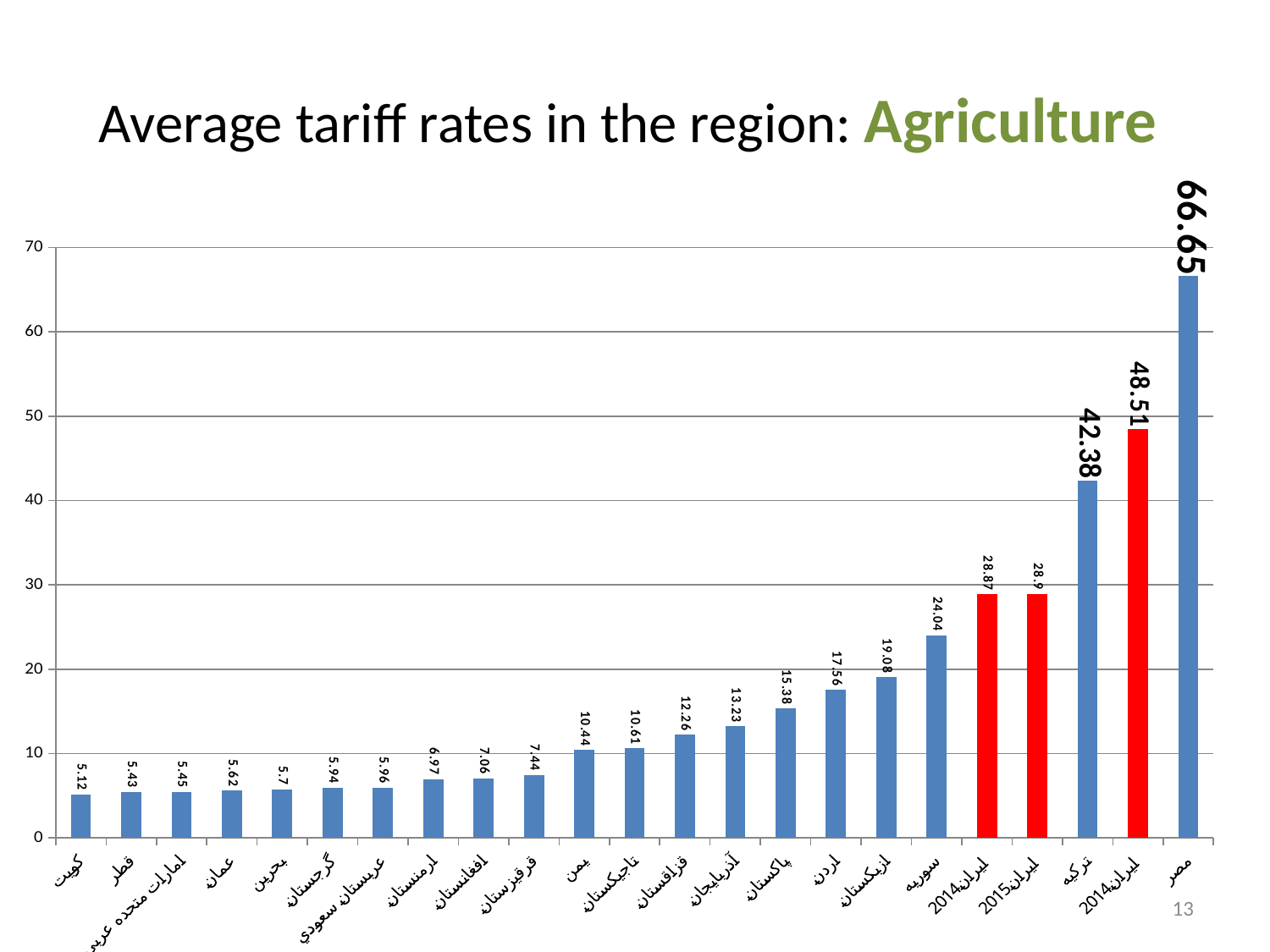
How many bars are shown in the chart? 23 What is the value for سوریه? 24.04 What is the value for ترکیه? 42.38 Which category has the highest value? مصر What is the value for پاکستان? 15.38 Which category has the lowest value? کویت What is the difference between the values for مصر and ترکیه? 24.27 How many bars are coloured red? 3 Which is larger, the value for اردن or the value for ازبکستان? ازبکستان What kind of chart is shown on the slide? bar chart What is the value for مصر? 66.65 Is the value for ایران2015 greater or less than 30? less